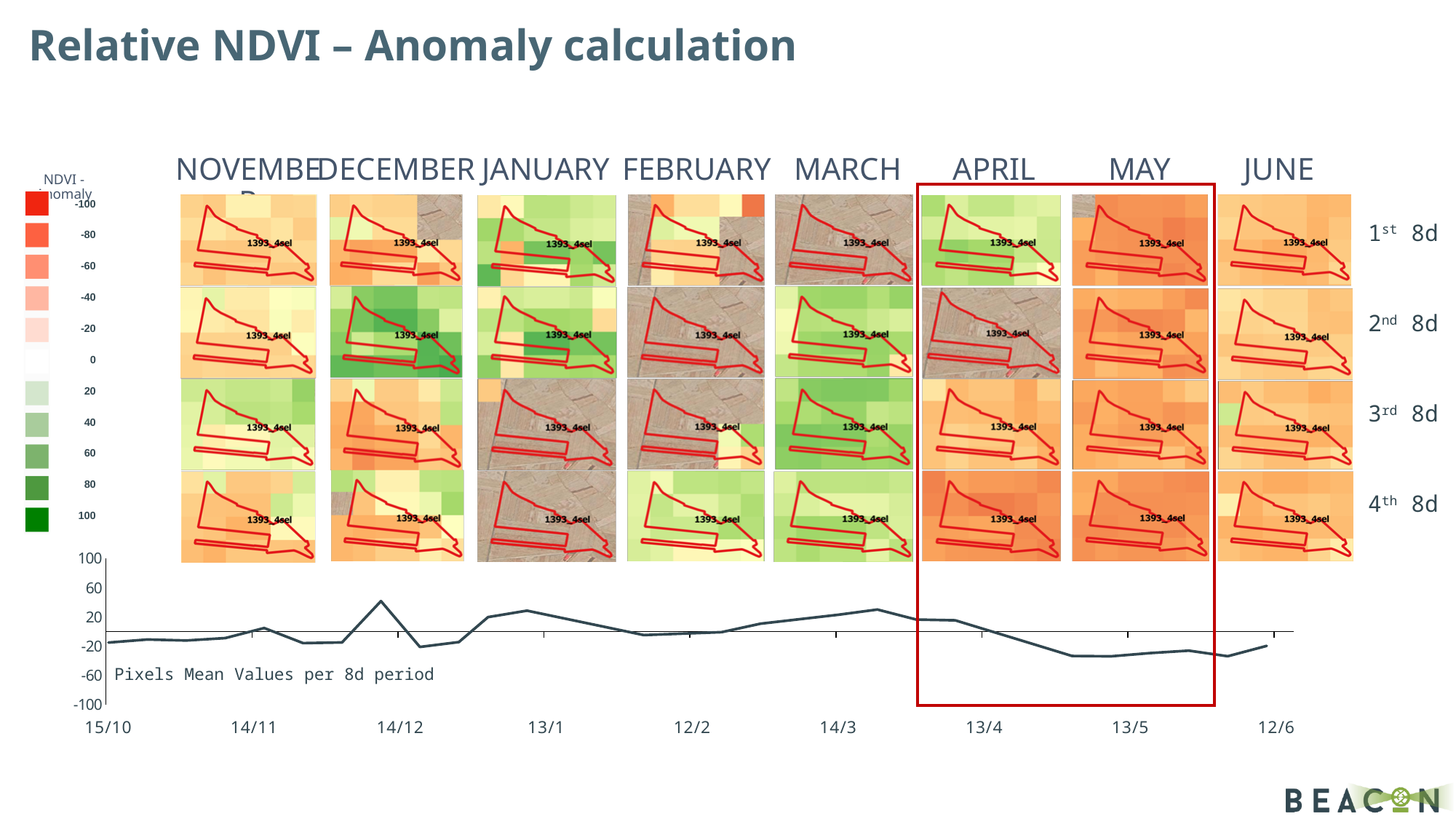
How many date labels are shown on the x axis of the line chart? 9 Is the highest peak of the line greater or less than 20? greater Is the value of the line at 15/10 greater or less than 0? less What is the first date label on the x axis of the line chart? 15/10 What is the last date label on the x axis of the line chart? 12/6 Does the line rise or fall between 13/4 and 13/5? fall Which is larger, the value of the line at 14/3 or at 13/5? 14/3 What kind of chart is shown at the bottom of the slide? line chart Is the value of the line at 13/5 greater or less than -20? less Near which x-axis date does the line reach its highest value? 14/12